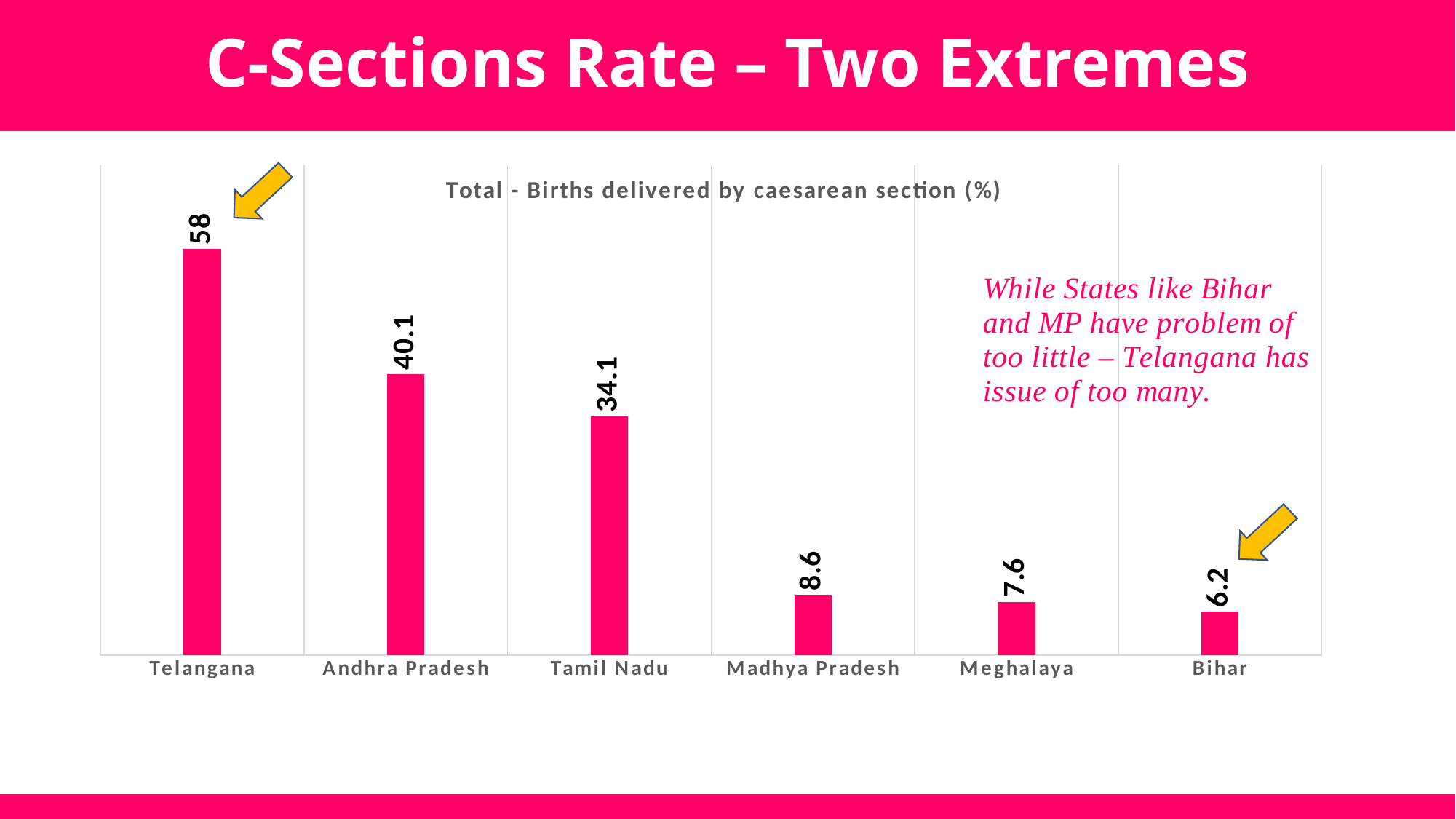
Which state has the lowest value? Bihar Which state has the highest value? Telangana What is the difference between the values for Telangana and Bihar? 51.8 Which is larger, the value for Madhya Pradesh or the value for Meghalaya? Madhya Pradesh What is the value for Telangana? 58 What is the value for Andhra Pradesh? 40.1 How many states are shown in the chart? 6 What is the title of the chart? Total - Births delivered by caesarean section (%) What is the value for Bihar? 6.2 What is the value for Tamil Nadu? 34.1 What is the difference between the values for Andhra Pradesh and Tamil Nadu? 6 What kind of chart is shown on the slide? Bar chart